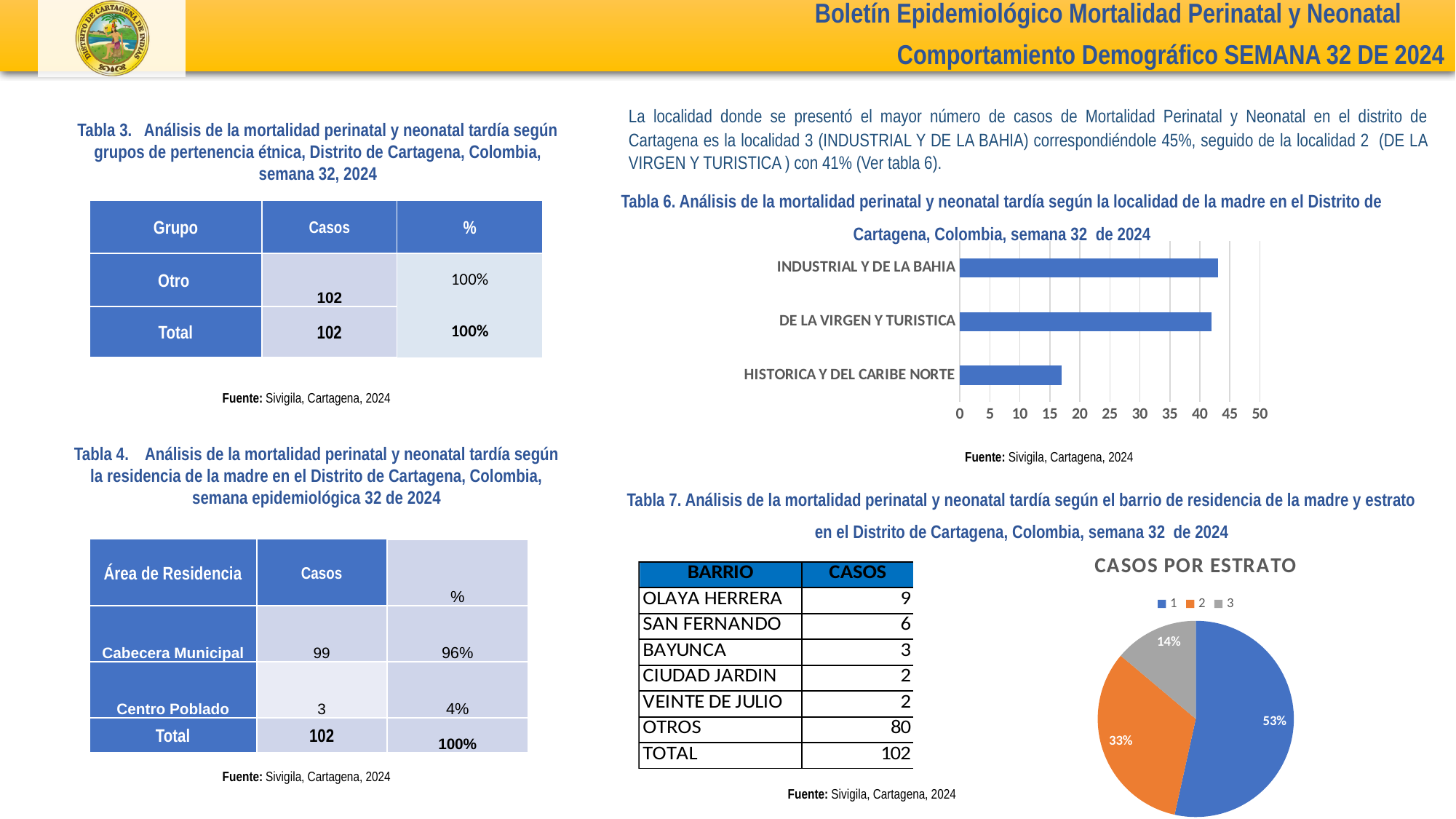
How many entries does the legend of the CASOS POR ESTRATO pie chart list? 3 In the Tabla 6 bar chart, is the value for INDUSTRIAL Y DE LA BAHIA greater or less than 40? greater In the Tabla 6 bar chart, is the value for INDUSTRIAL Y DE LA BAHIA greater or less than 45? less In the CASOS POR ESTRATO pie chart, what is the difference in percentage points between estrato 1 and estrato 2? 20 What kind of chart is the chart under Tabla 6 (localidad de la madre)? bar chart In the CASOS POR ESTRATO pie chart, what share does estrato 1 have? 53% In the Tabla 6 bar chart, what is the highest value shown on the horizontal axis? 50 What kind of chart is the CASOS POR ESTRATO chart? pie chart In the Tabla 6 bar chart, how many localidades are plotted? 3 In the Tabla 6 bar chart, which localidad has the lowest value? HISTORICA Y DEL CARIBE NORTE In the Tabla 6 bar chart, is the value for HISTORICA Y DEL CARIBE NORTE greater or less than 20? less In the CASOS POR ESTRATO pie chart, which estrato has the smallest share? 3